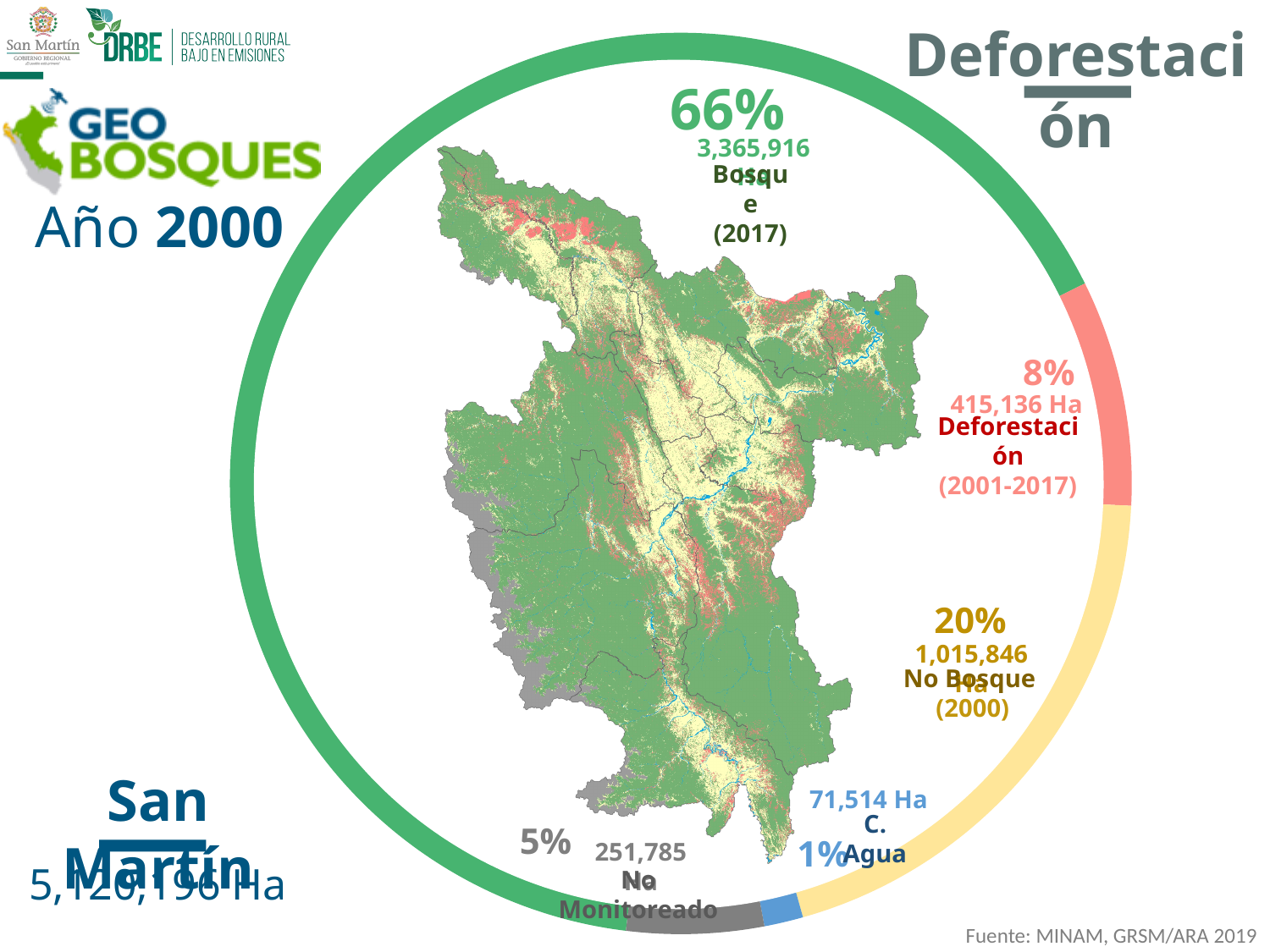
What is the area in hectares shown for Deforestación (2001-2017)? 415,136 Ha What percentage share does No Monitoreado have in the donut chart? 5% Which category has the largest share of the donut chart? Bosque (2017) What percentage share does No Bosque (2000) have in the donut chart? 20% What is the difference in percentage points between No Bosque (2000) and Deforestación (2001-2017)? 12% What kind of chart is shown on the slide? Donut (pie) chart Which is larger, the share for Deforestación (2001-2017) or the share for No Monitoreado? Deforestación (2001-2017) How many categories are shown in the donut chart? 5 What colour is the Deforestación (2001-2017) segment of the donut chart? Red (salmon) Which category has the smallest share of the donut chart? C. Agua What is the area in hectares shown for C. Agua? 71,514 Ha What percentage share does Bosque (2017) have in the donut chart? 66%